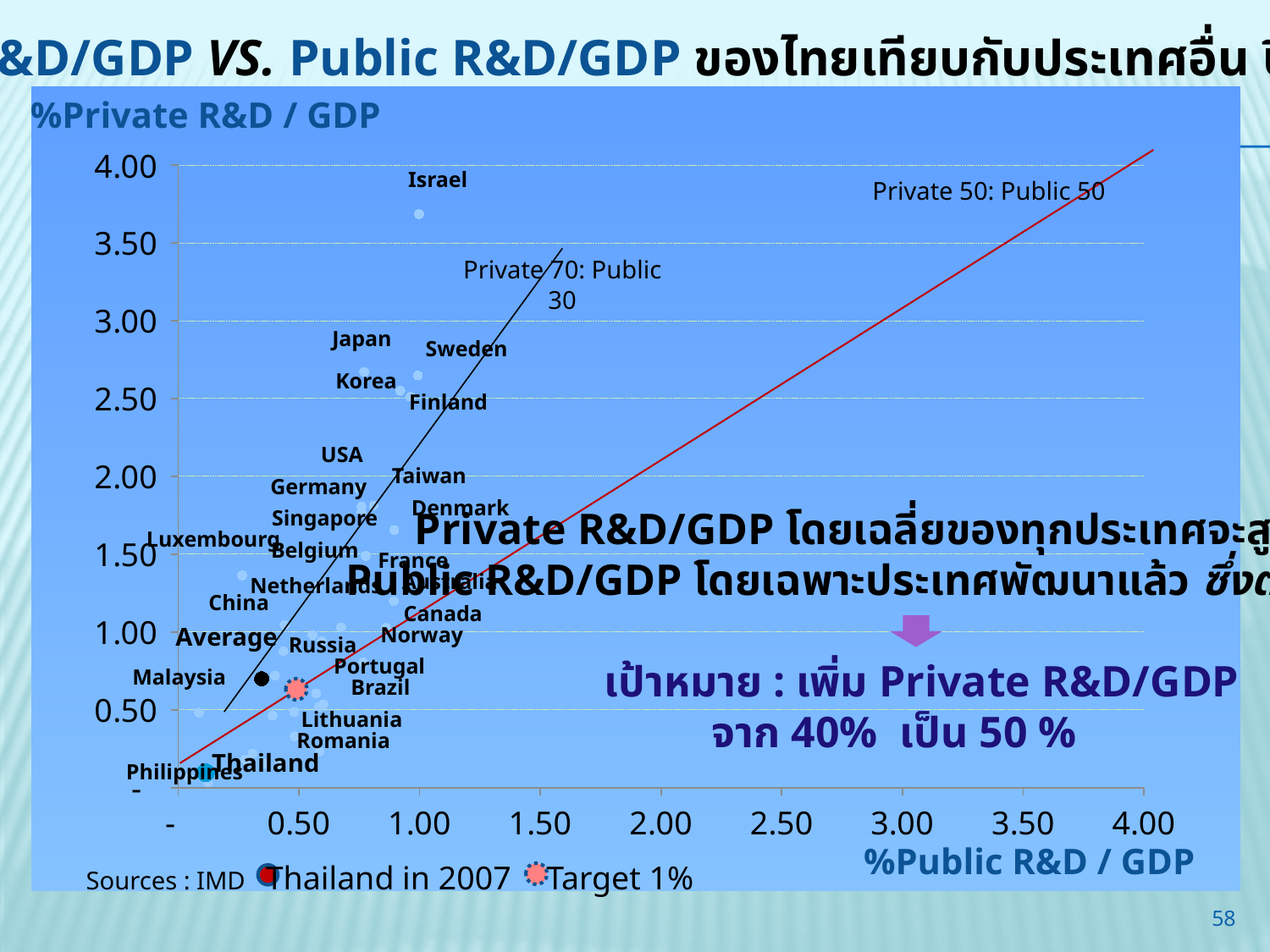
Which has a higher %Private R&D / GDP, Malaysia or Japan? Japan Is the %Private R&D / GDP value for Korea greater or less than 2.00? greater What kind of chart is shown on the slide? scatter chart What is the label of the horizontal axis of the chart? %Public R&D / GDP Is the %Private R&D / GDP value for Philippines greater or less than 0.50? less Is the %Private R&D / GDP value for Japan greater or less than 2.50? greater Which country has the highest %Private R&D / GDP on the chart? Israel Which has a higher %Private R&D / GDP, Israel or Sweden? Israel What ratio does the red reference line on the chart represent? Private 50: Public 50